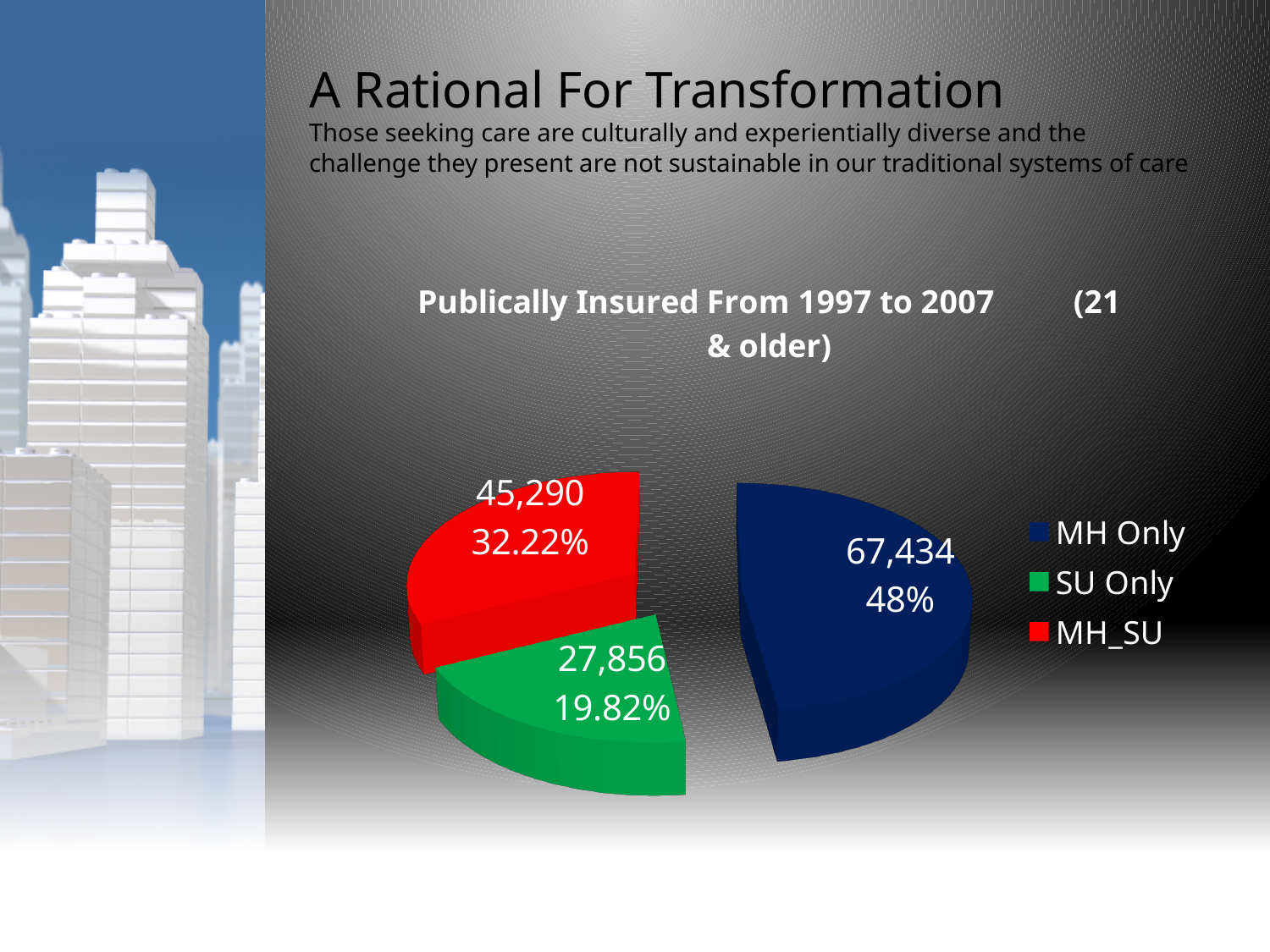
What is the value for MH_SU? 45,290 Which is larger, the value for MH_SU or the value for SU Only? MH_SU What share of the pie does MH_SU represent? 32.22% What is the difference between the values for MH Only and MH_SU? 22,144 What is the value for MH Only? 67,434 What is the value for SU Only? 27,856 Which category has the smallest slice? SU Only What kind of chart is shown on the slide? Pie chart Which category has the largest slice? MH Only What share of the pie does MH Only represent? 48% How many categories does the pie chart show? 3 What share of the pie does SU Only represent? 19.82%